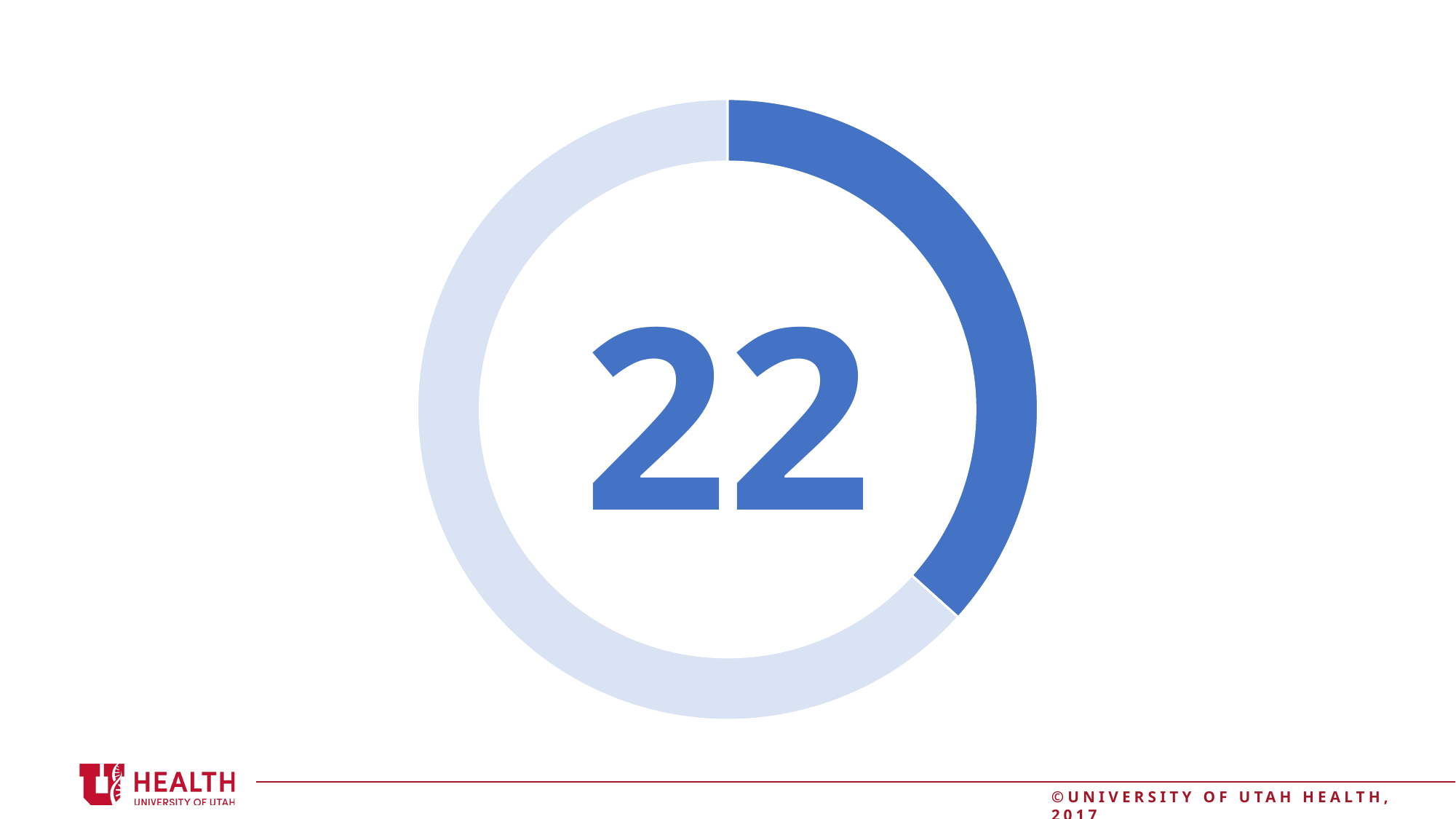
Does the dark blue segment cover more or less than half of the doughnut chart? less What number is printed in the centre of the doughnut chart? 22 Which segment of the doughnut chart is larger, the dark blue one or the light blue one? the light blue one Does the doughnut chart have a legend? No What kind of chart is shown on the slide? doughnut chart What colour is the smaller segment of the doughnut chart? dark blue How many segments does the doughnut chart have? 2